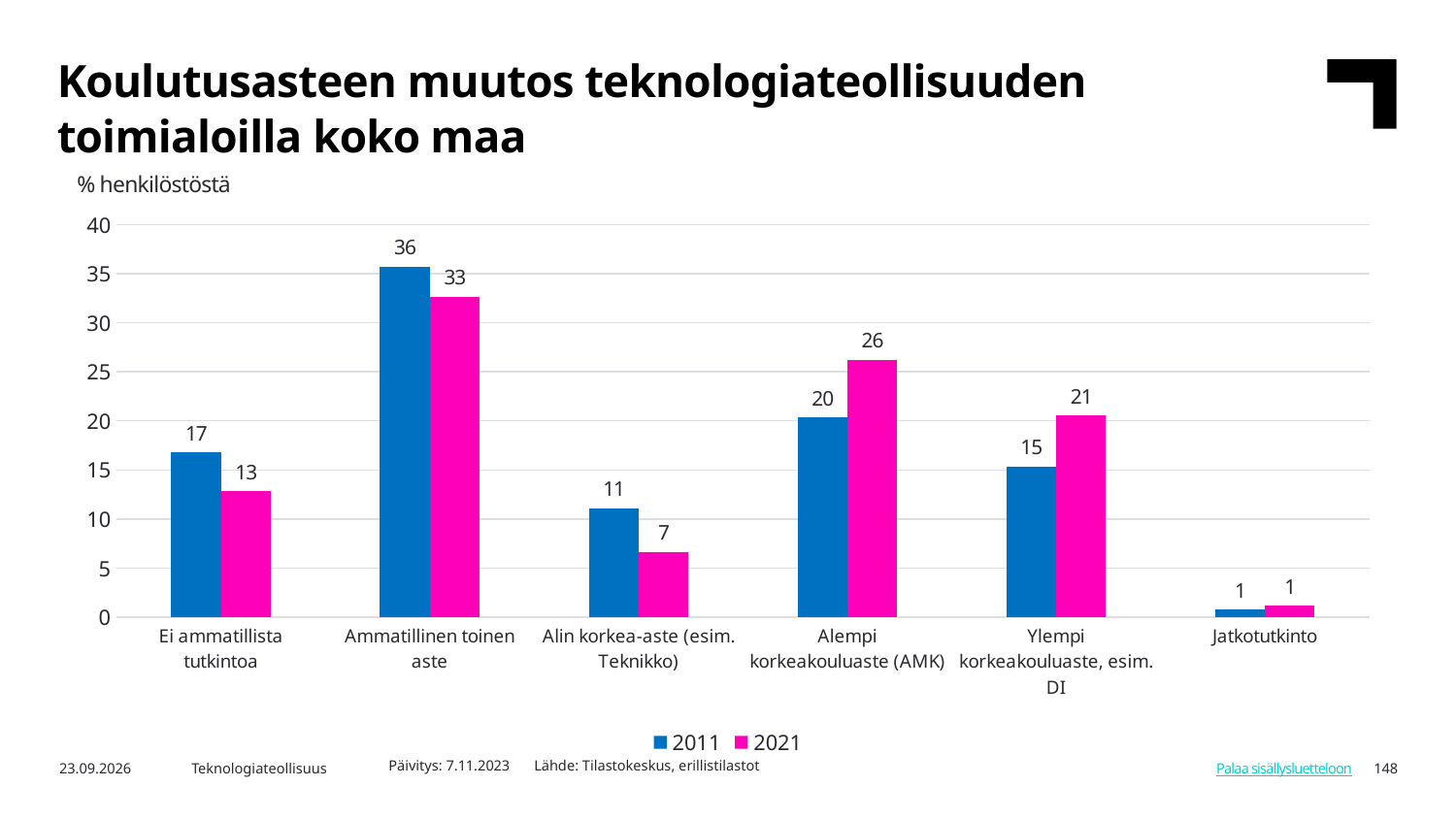
What is the value for Alin korkea-aste (esim. Teknikko) in 2021? 7 What kind of chart is shown on the slide? Bar chart Which category has the lowest value in 2011? Jatkotutkinto How many series does the legend list? 2 What is the value for Alempi korkeakouluaste (AMK) in 2021? 26 Which category has the highest value in 2021? Ammatillinen toinen aste Which is larger for Ei ammatillista tutkintoa: the 2011 value or the 2021 value? 2011 What is the value for Ammatillinen toinen aste in 2011? 36 Is the 2021 value for Ammatillinen toinen aste greater or less than 30? greater What is the difference between the 2011 and 2021 values for Ylempi korkeakouluaste, esim. DI? 6 What unit is shown above the chart? % henkilöstöstä How many categories are shown on the x axis? 6